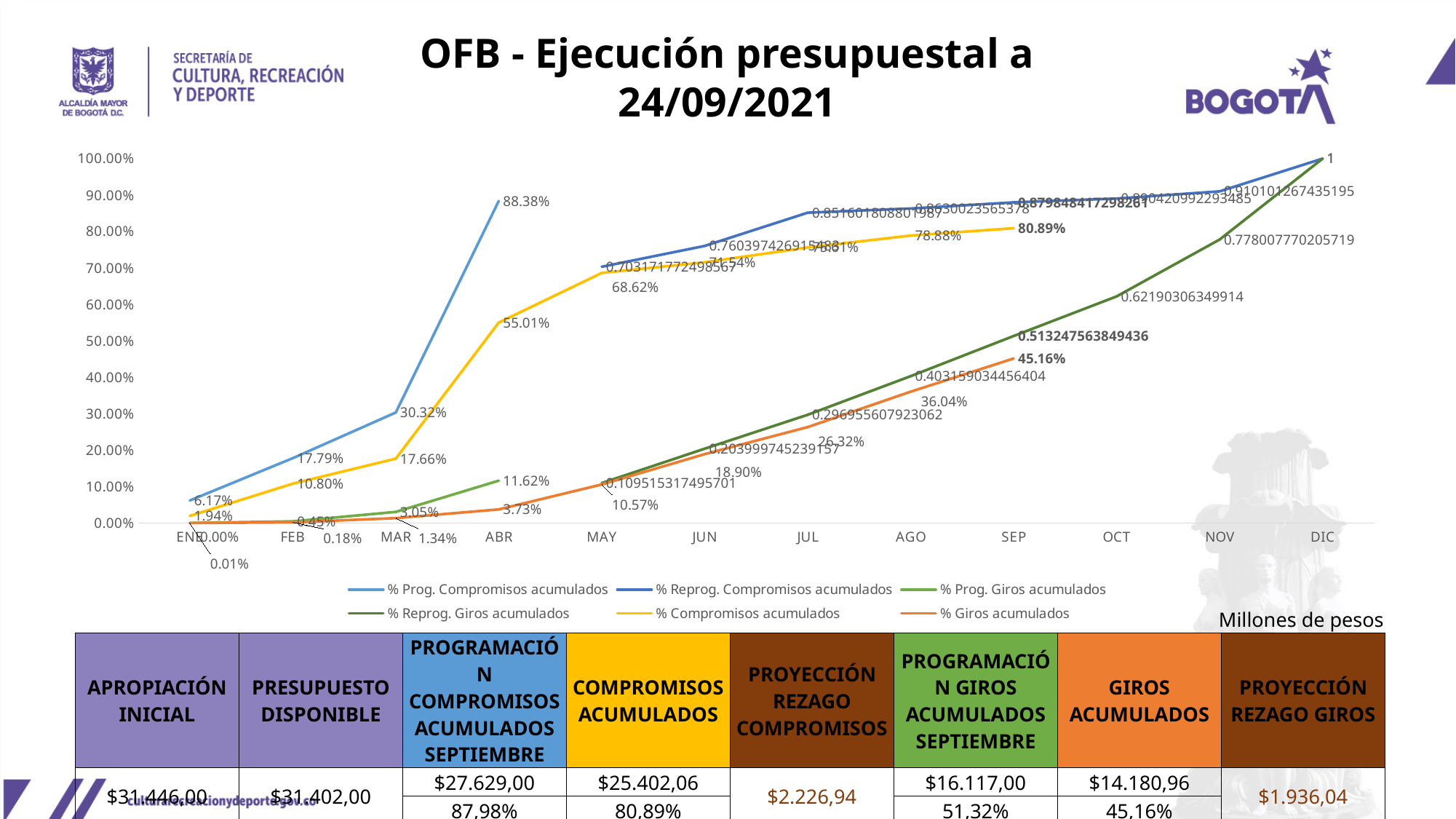
Is the value of % Reprog. Giros acumulados in NOV greater or less than 70.00%? greater What kind of chart is shown on the slide? line chart What is the value of % Giros acumulados in MAY? 10.57% What is the value of % Prog. Compromisos acumulados in ABR? 88.38% What is the value of % Prog. Giros acumulados in ABR? 11.62% What is the value of % Compromisos acumulados in SEP? 80.89% In ABR, which is larger: % Prog. Compromisos acumulados or % Compromisos acumulados? % Prog. Compromisos acumulados How many months are shown on the x axis? 12 What is the value of % Giros acumulados in SEP? 45.16% Does % Giros acumulados rise or fall from ENE to SEP? rise How many series does the legend list? 6 What is the difference between % Compromisos acumulados and % Giros acumulados in SEP? 35.73%